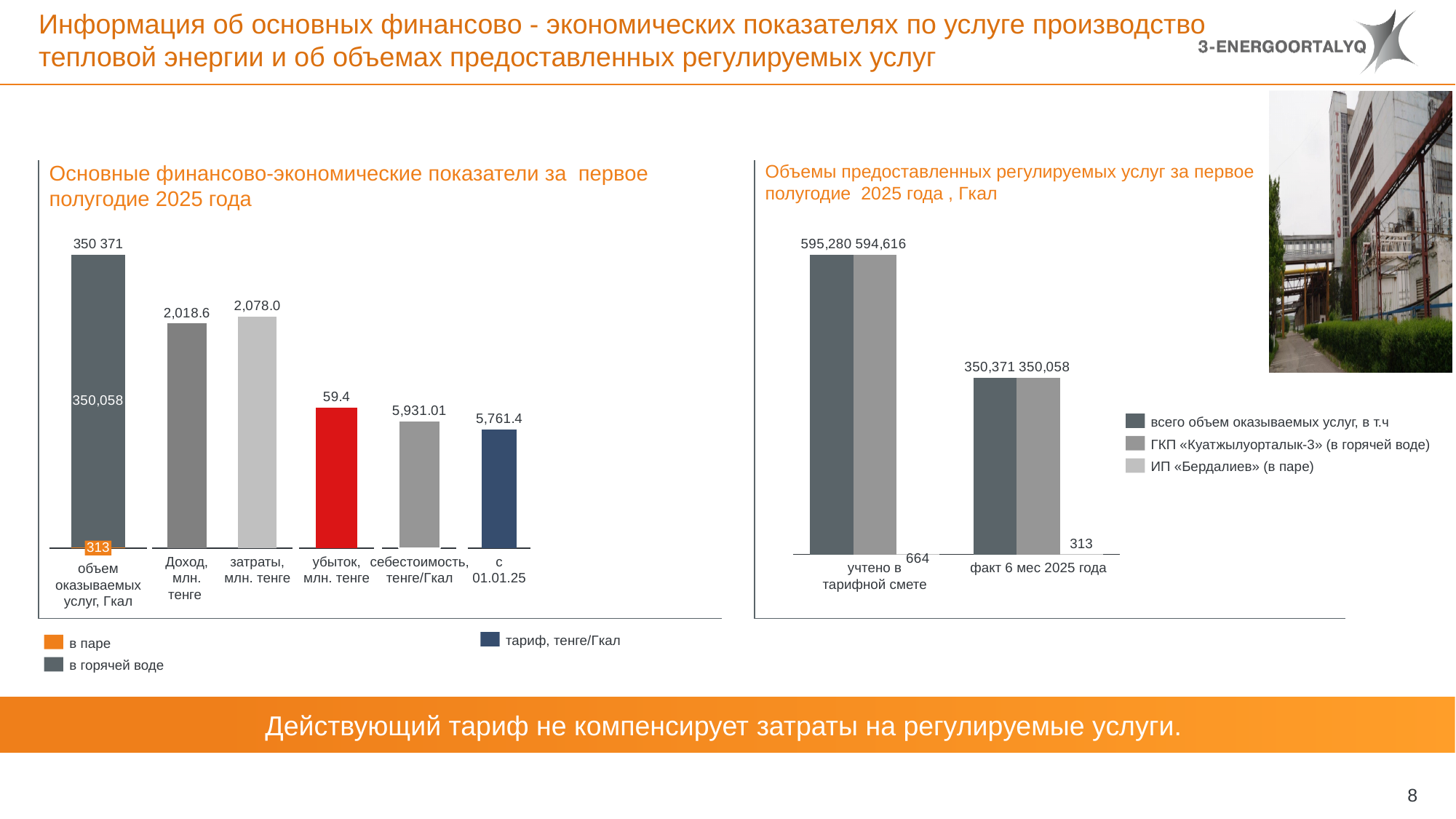
How many series does the legend of the right chart list? 3 In the left chart, what is the total labelled at the top of the stacked bar 'объем оказываемых услуг, Гкал'? 350 371 In the left chart 'Основные финансово-экономические показатели за первое полугодие 2025 года', what is the value labelled for 'Доход, млн. тенге'? 2,018.6 In the left chart, what is the value of the red bar 'убыток, млн. тенге'? 59.4 In the left chart, what is the value labelled for 'затраты, млн. тенге'? 2,078.0 In the left chart, what is the difference between 'затраты, млн. тенге' and 'Доход, млн. тенге'? 59.4 In the left chart, which is larger: 'себестоимость, тенге/Гкал' or the tariff 'с 01.01.25'? себестоимость, тенге/Гкал In the right chart 'Объемы предоставленных регулируемых услуг за первое полугодие 2025 года, Гкал', what is the value of 'всего объем оказываемых услуг' for 'учтено в тарифной смете'? 595,280 In the right chart, what is the value of 'ИП «Бердалиев» (в паре)' for 'факт 6 мес 2025 года'? 313 In the left chart, what is the tariff value labelled for 'с 01.01.25'? 5,761.4 In the left chart, what is the value labelled for 'себестоимость, тенге/Гкал'? 5,931.01 What type of chart is the right chart 'Объемы предоставленных регулируемых услуг'? bar chart